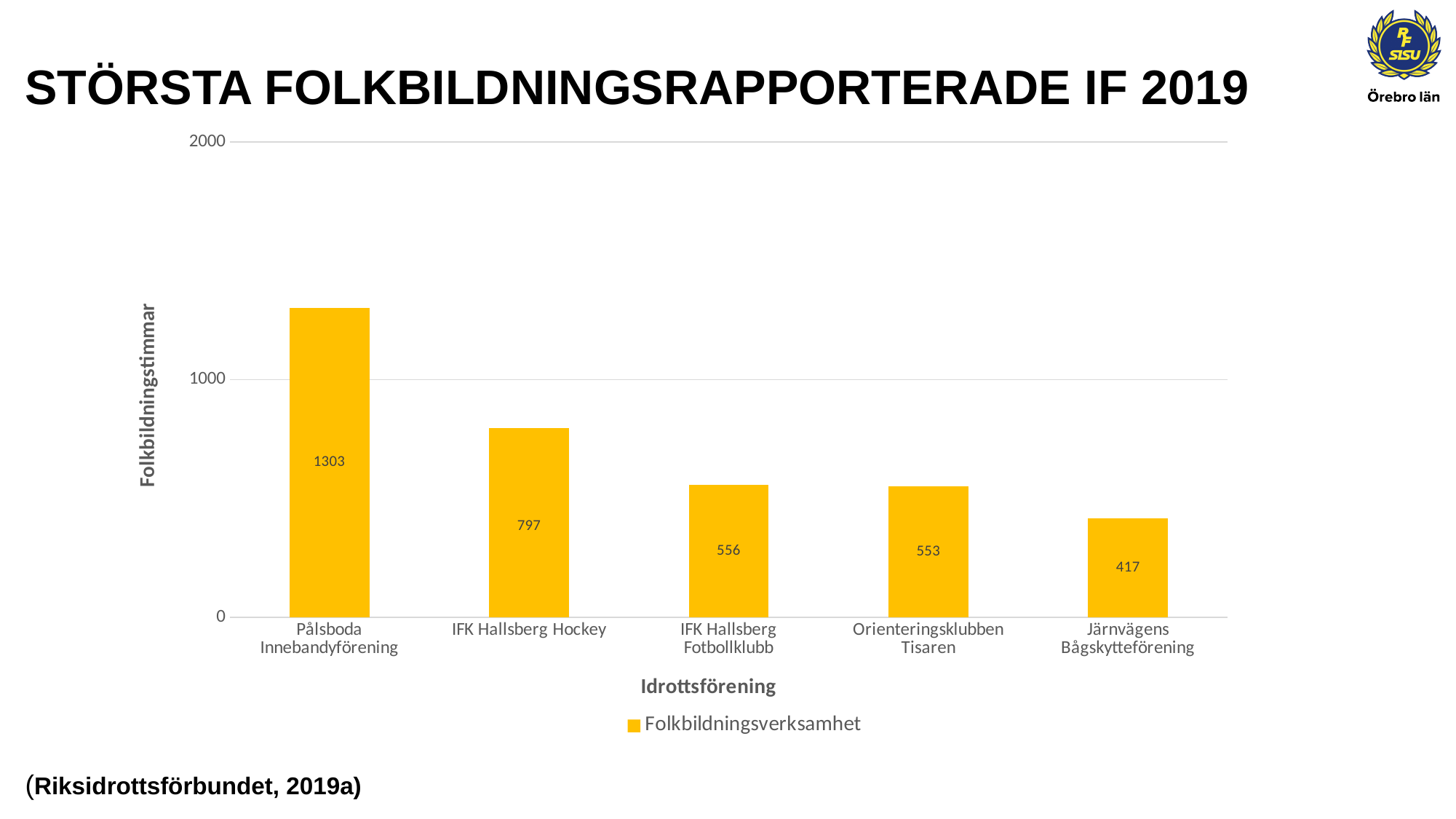
What is the value for IFK Hallsberg Hockey? 797 Is the value for IFK Hallsberg Hockey greater or less than 1000? less What is the label of the y axis? Folkbildningstimmar Which category has the lowest value? Järnvägens Bågskytteförening What is the difference between the values for IFK Hallsberg Fotbollklubb and Orienteringsklubben Tisaren? 3 Which category has the highest value? Pålsboda Innebandyförening What is the difference between the values for Pålsboda Innebandyförening and IFK Hallsberg Hockey? 506 How many categories are shown on the x axis? 5 What is the value for Pålsboda Innebandyförening? 1303 What is the value for Järnvägens Bågskytteförening? 417 Which is larger, the value for IFK Hallsberg Hockey or the value for Järnvägens Bågskytteförening? IFK Hallsberg Hockey What kind of chart is shown on the slide? bar chart